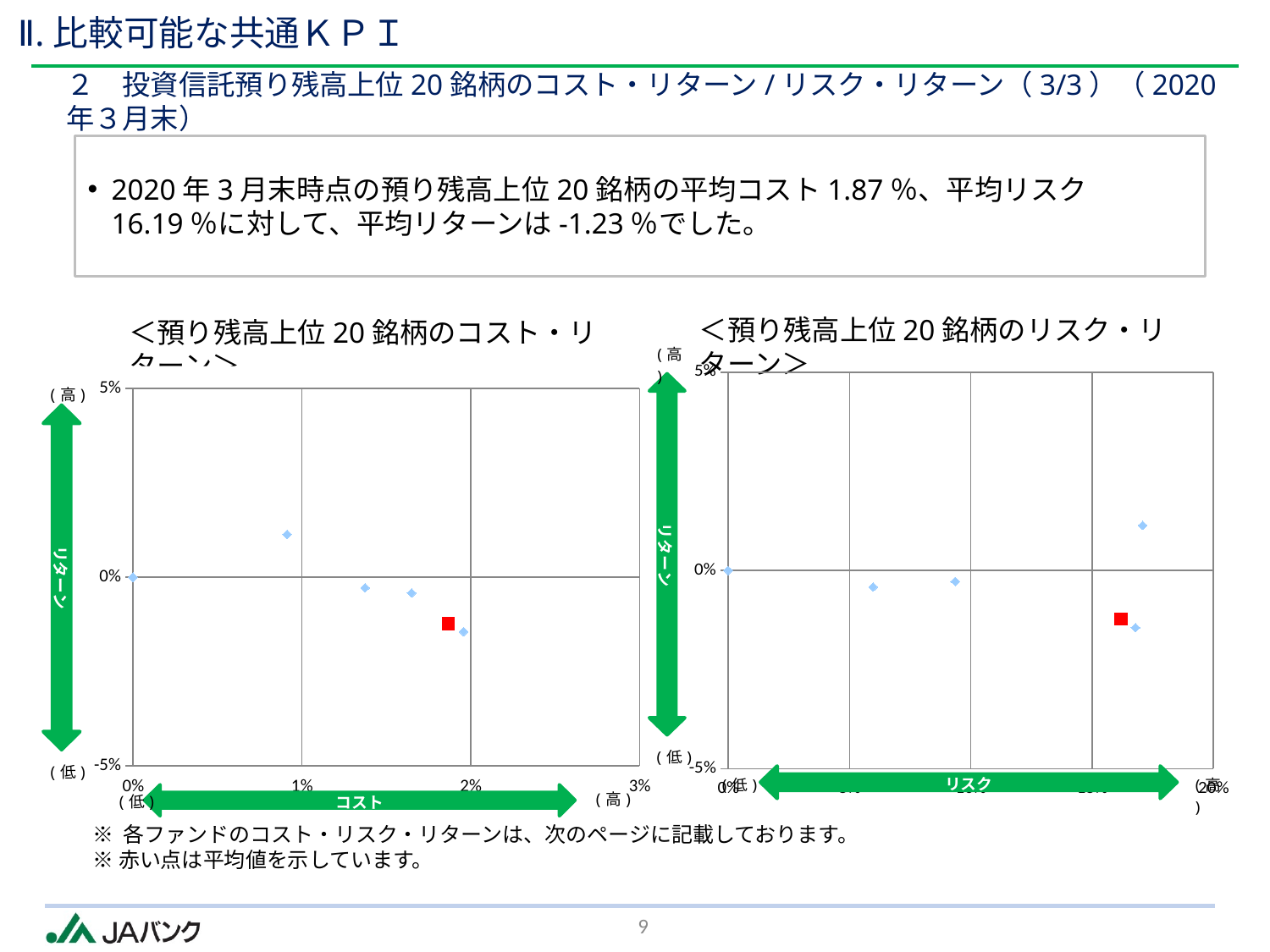
What kind of chart is the right chart titled <預り残高上位20銘柄のリスク・リターン>? Scatter chart What kind of chart is the left chart titled <預り残高上位20銘柄のコスト・リターン>? Scatter chart In the right risk-return chart, what is the average risk shown by the red point? 16.19% In the left cost-return chart, is the return of the red average point greater or less than 0%? less In the left cost-return chart, is the cost of the red average point greater or less than 1%? greater What is the label of the horizontal axis in the left chart? コスト In the right risk-return chart, is the risk of the red average point greater or less than 15%? greater In the left cost-return chart, what is the average cost shown by the red point? 1.87% What is the range of the vertical axis in the left cost-return chart? -5% to 5% What does the red point in each chart represent, according to the note on the slide? 平均値 (the average value) In the left cost-return chart, what is the average return shown by the red point? -1.23%